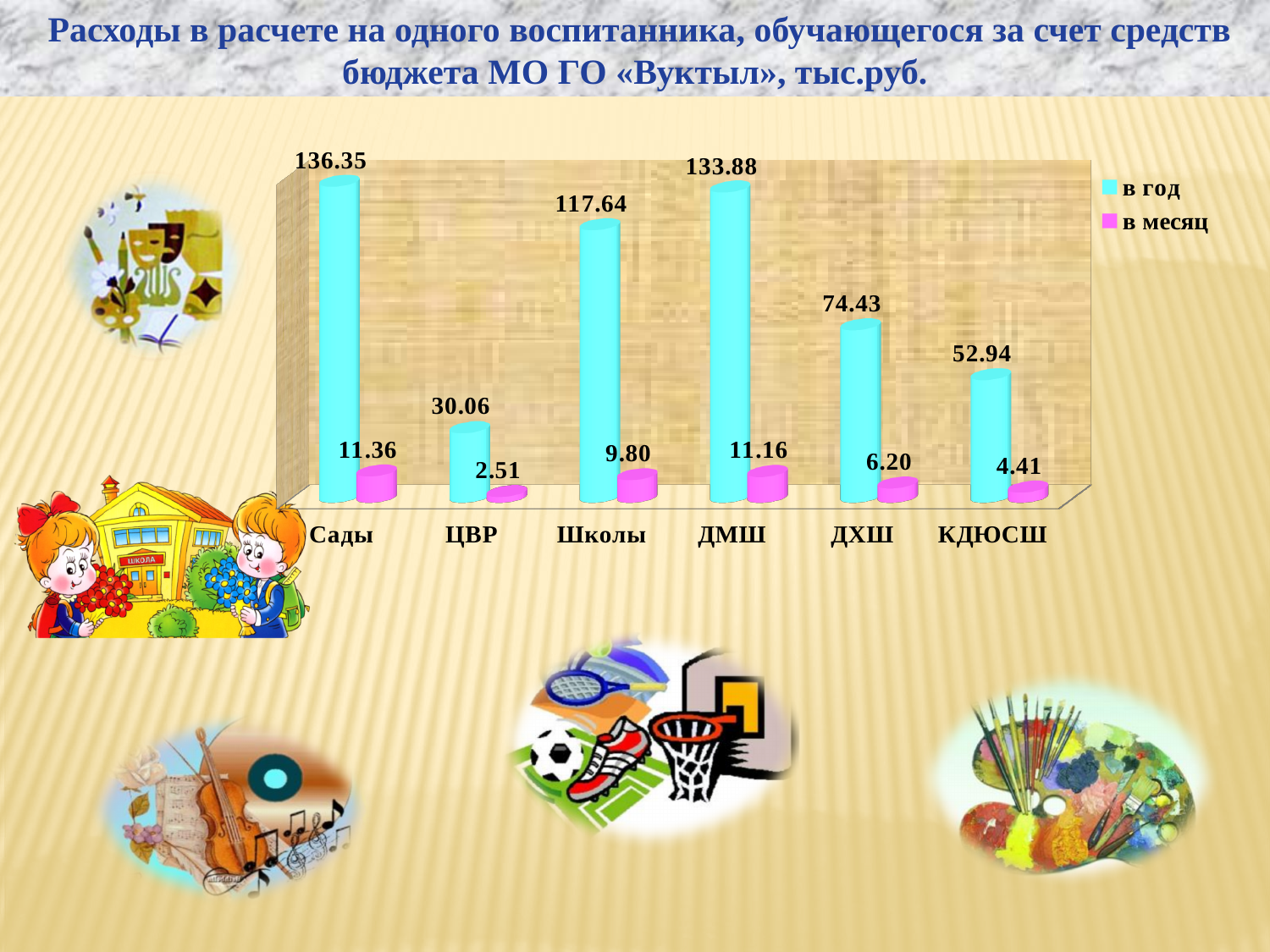
How many series does the legend list? 2 How many categories are shown on the x axis? 6 What is the difference between the "в год" values for Школы and ДХШ? 43.21 What is the value of "в месяц" for КДЮСШ? 4.41 What is the value of "в месяц" for Школы? 9.80 What are the two series named in the legend? в год and в месяц Which category has the lowest "в месяц" value? ЦВР What is the value of "в год" for Сады? 136.35 What kind of chart is shown on the slide? Bar chart Which is larger, the "в год" value for ДМШ or for Школы? ДМШ What is the value of "в год" for ДХШ? 74.43 Which category has the highest "в год" value? Сады